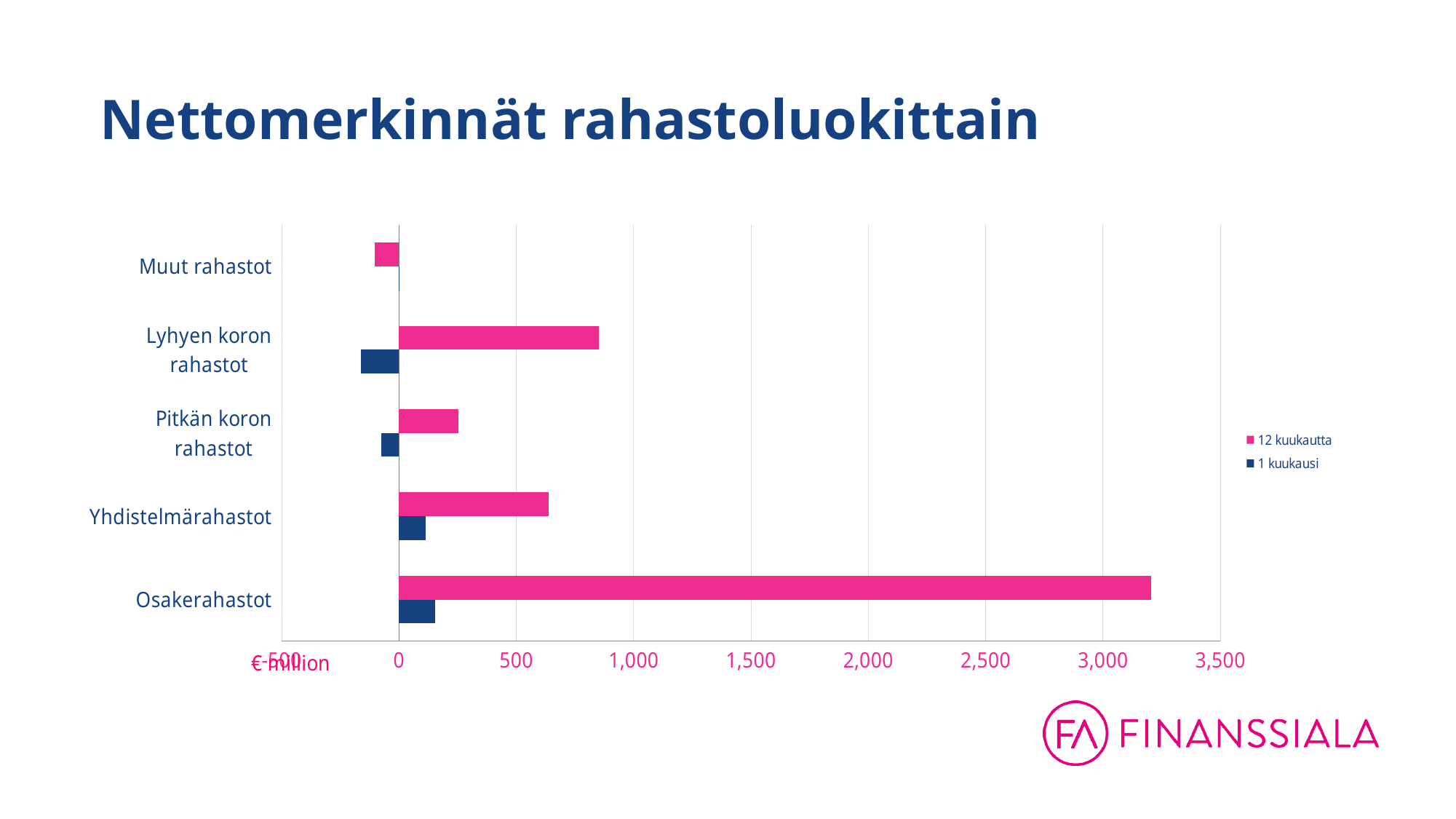
Is the 12 kuukautta value for Lyhyen koron rahastot greater or less than 500? greater What is the title of the chart? Nettomerkinnät rahastoluokittain Is the 12 kuukautta value for Osakerahastot greater or less than 3,000? greater Which category has the lowest value for the 12 kuukautta series? Muut rahastot What unit is shown on the horizontal axis? € million How many fund categories are shown on the chart? 5 How many series does the legend list? 2 Which is larger for the 12 kuukautta series: Lyhyen koron rahastot or Yhdistelmärahastot? Lyhyen koron rahastot What kind of chart is shown on the slide? bar chart Is the 12 kuukautta value for Pitkän koron rahastot greater or less than 500? less Which category has the highest value for the 12 kuukautta series? Osakerahastot